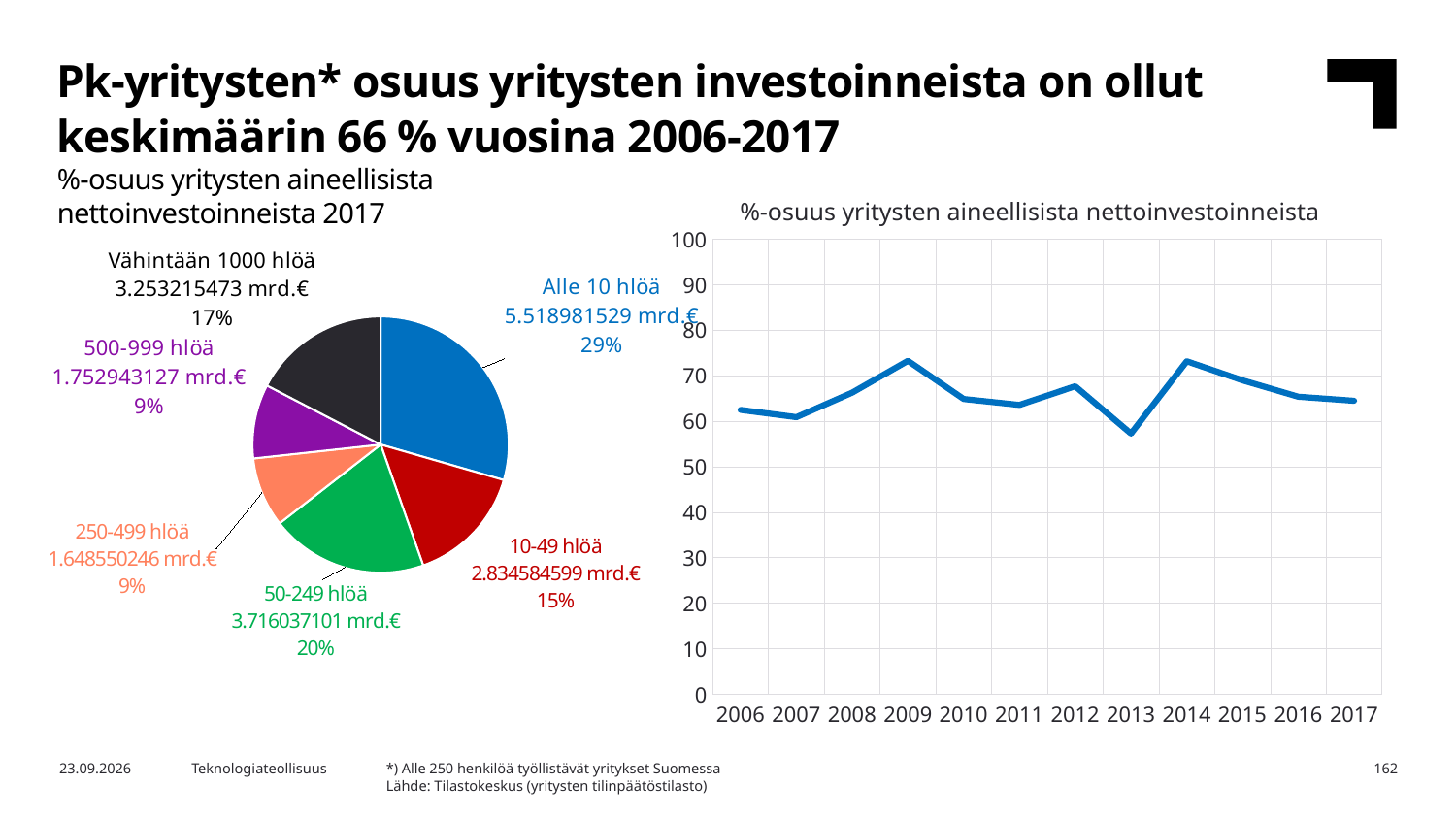
On the pie chart on the left, what percentage share is shown for 'Vähintään 1000 hlöä'? 17% On the pie chart on the left, which is larger: the share of '50-249 hlöä' or the share of 'Vähintään 1000 hlöä'? 50-249 hlöä On the pie chart on the left, what value in mrd.€ is shown for '50-249 hlöä'? 3.716037101 mrd.€ On the pie chart on the left, what is the difference in percentage points between the shares of 'Alle 10 hlöä' and '10-49 hlöä'? 14 What kind of chart is the chart on the right of the slide? Line chart On the line chart on the right, how many years are shown on the x axis? 12 On the pie chart on the left, which category has the largest share? Alle 10 hlöä On the line chart on the right, is the value for 2009 greater or less than 70? greater On the pie chart on the left, what percentage share is shown for 'Alle 10 hlöä'? 29% How many slices does the pie chart on the left have? 6 On the line chart on the right, which year has the lowest value? 2013 On the line chart on the right, is the value for 2013 greater or less than 60? less